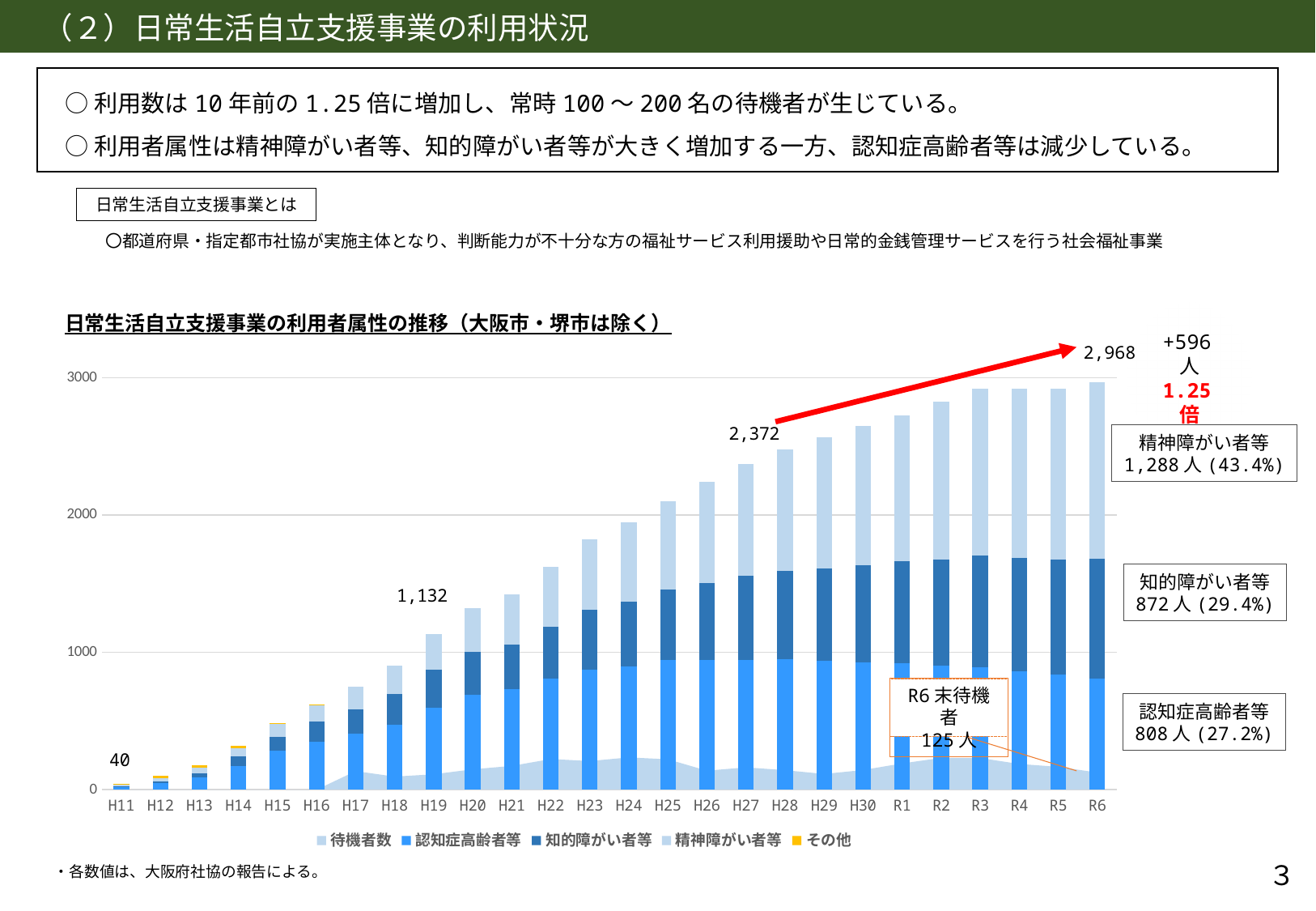
Is the total bar height for H23 greater or less than 2000? less What value is labelled for H27 in the chart? 2,372 What is the difference between the labelled values for H27 and H19? 1,240 What is the value labelled for H11 in the chart? 40 What value is labelled for H19 in the chart? 1,132 What is the total number of users shown for R6 in the chart? 2,968 How many series does the chart legend list? 5 Which year has the shortest bar in the chart? H11 Do the bar totals generally rise or fall from H11 to R6? rise By how much did the labelled total increase from H27 (2,372) to R6 (2,968)? 596 How many years (categories) are shown on the x axis of the chart? 26 Which year has the tallest bar in the chart? R6